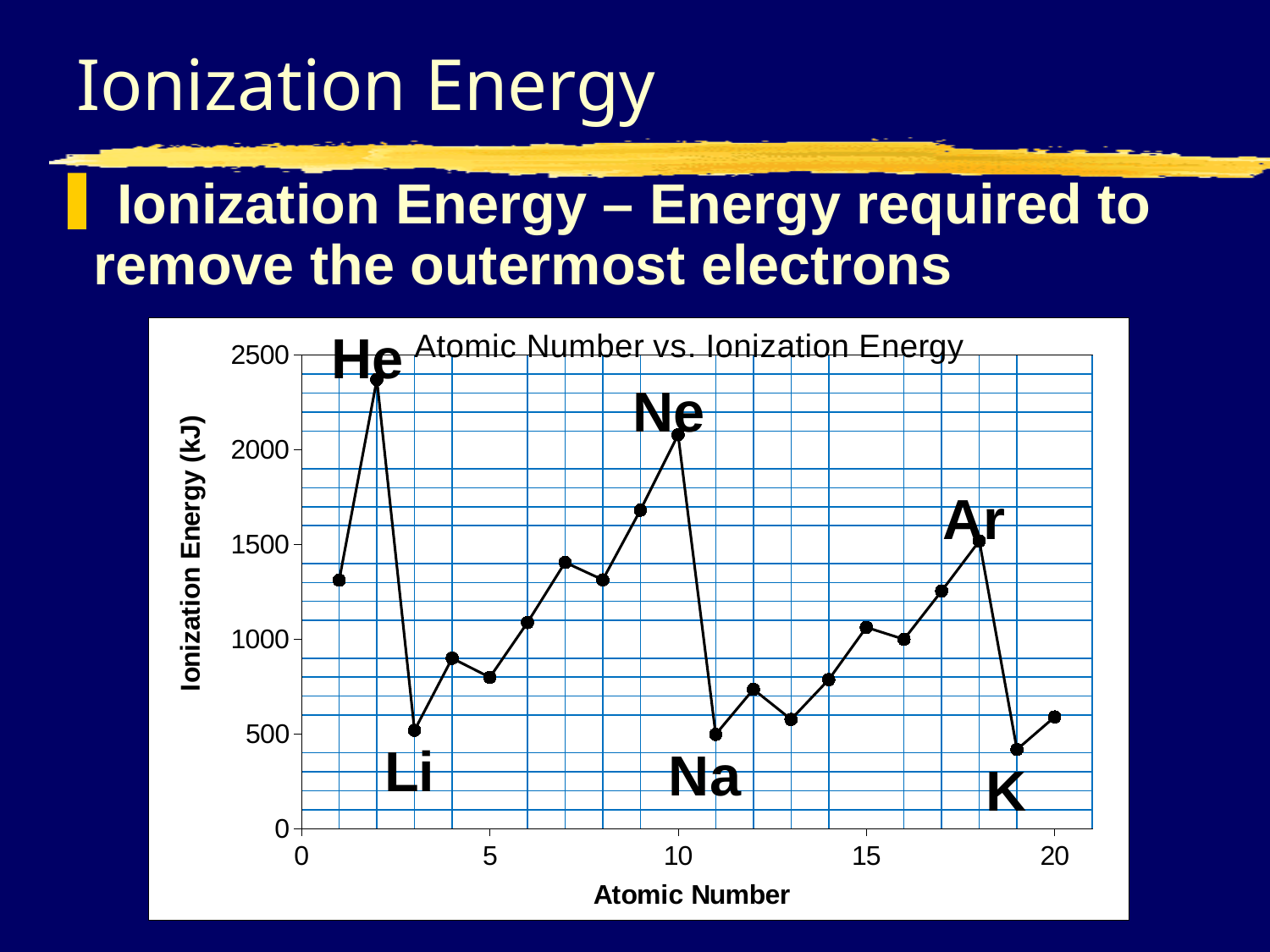
Is the ionization energy for He greater or less than 2000? greater Between atomic numbers 11 and 18, does the ionization energy generally rise or fall? rise Is the ionization energy for K greater or less than 500? less What is the label of the vertical axis of the chart? Ionization Energy (kJ) What kind of chart is shown on the slide? line chart Which labeled element has the lowest ionization energy on the chart? K What is the title of the chart? Atomic Number vs. Ionization Energy Is the ionization energy for Ar greater or less than 2000? less Which has the higher ionization energy, He or Ne? He How many data points are plotted on the chart? 20 Which labeled element has the highest ionization energy on the chart? He